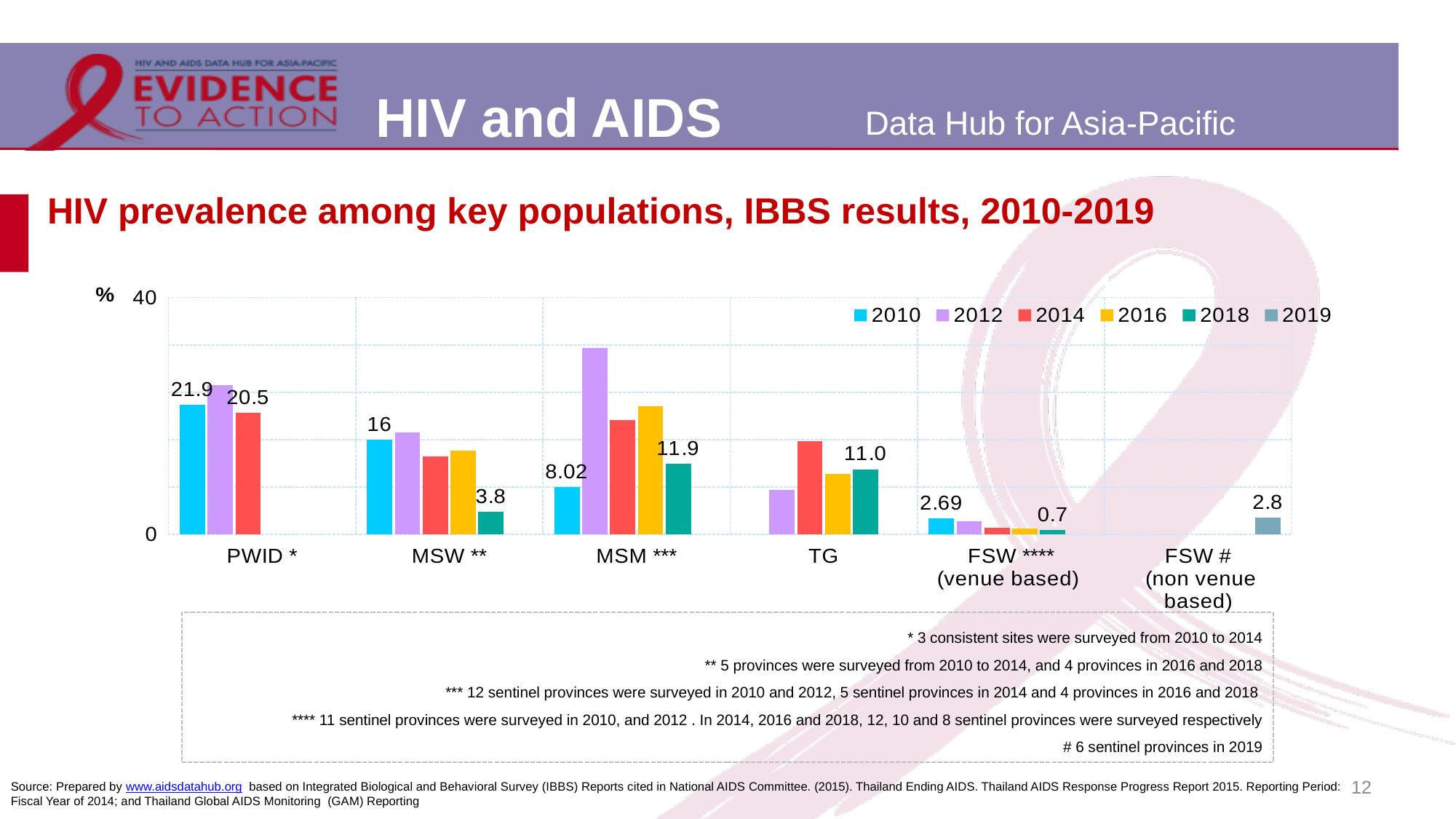
For PWID, which year has the higher HIV prevalence, 2010 or 2014? 2010 What is the HIV prevalence among TG in 2018? 11.0 Which year shows the highest HIV prevalence among MSM? 2012 By how much did HIV prevalence among MSM increase from 2010 to 2018? 3.88 What is the HIV prevalence among MSM in 2010? 8.02 How many years does the legend list? 6 What is the HIV prevalence among PWID in 2010? 21.9 How many key population categories are shown on the x axis? 6 What is the HIV prevalence among MSW in 2018? 3.8 What type of chart is used on this slide? Bar chart What is the difference between the 2010 and 2018 HIV prevalence among FSW (venue based)? 1.99 What is the HIV prevalence among FSW (non venue based) in 2019? 2.8